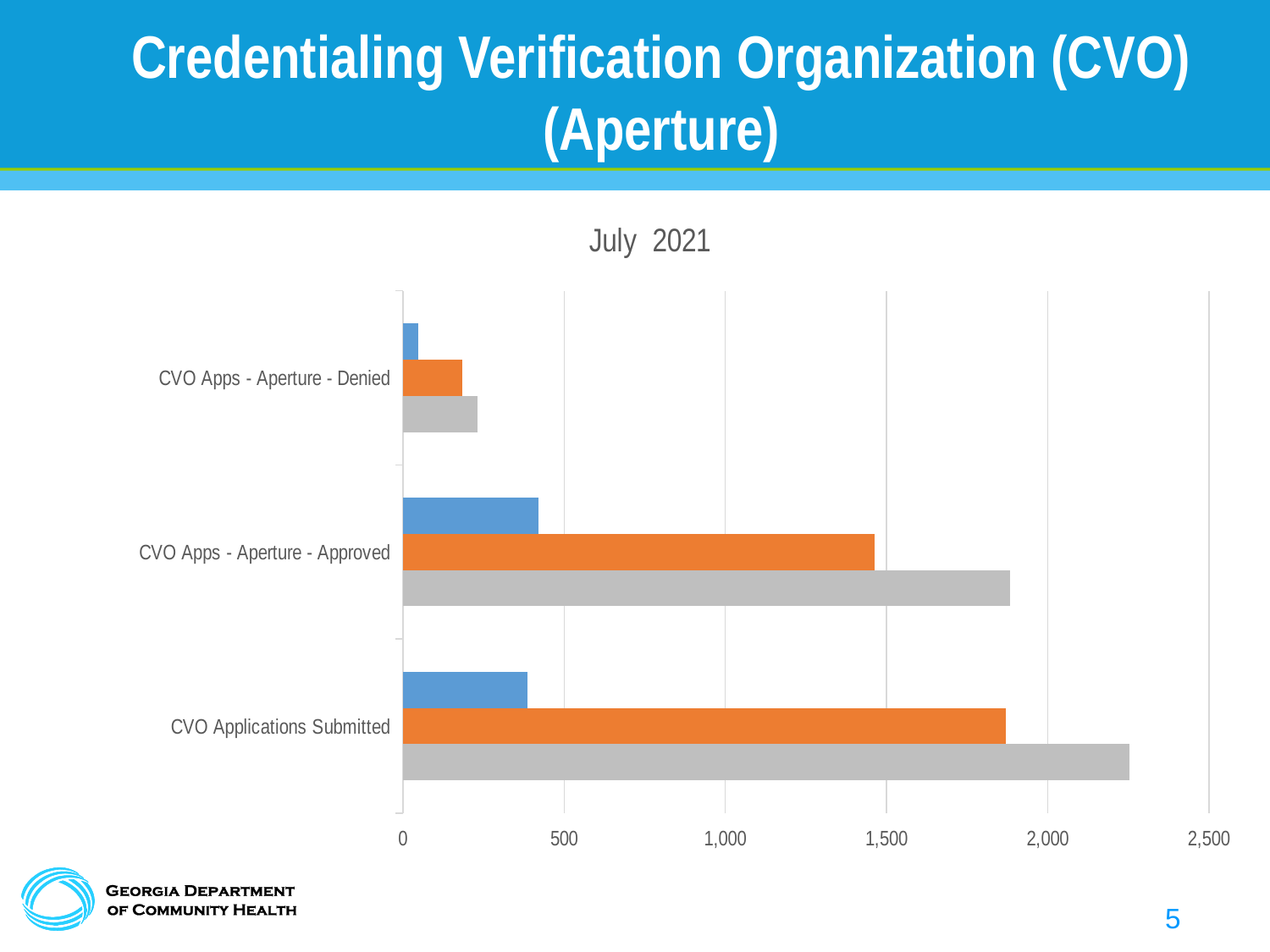
Which category has the shortest gray bar? CVO Apps - Aperture - Denied How many bars are plotted for each category? 3 Is the gray bar for CVO Applications Submitted greater or less than 2,000? greater Which is larger: the orange bar for CVO Applications Submitted or the orange bar for CVO Apps - Aperture - Approved? CVO Applications Submitted How many categories are shown on the chart? 3 Is the orange bar for CVO Applications Submitted greater or less than 1,500? greater Is the orange bar for CVO Apps - Aperture - Approved greater or less than 1,500? less Which category has the longest gray bar? CVO Applications Submitted What is the title of the chart? July 2021 What kind of chart is shown on the slide? bar chart